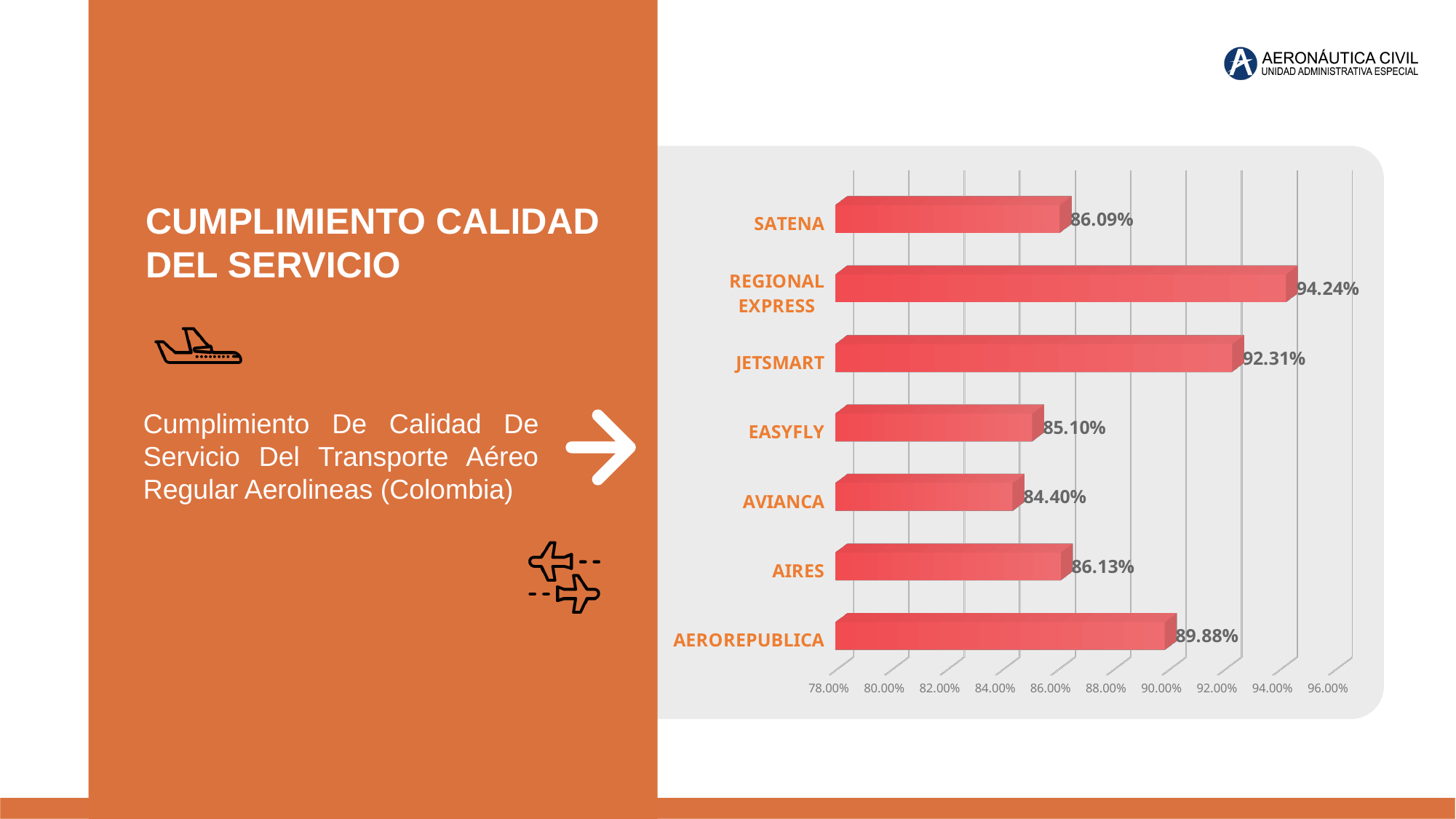
Which is larger, the value for SATENA or the value for EASYFLY? SATENA How many airlines are shown in the chart? 7 What is the lowest value shown on the x axis? 78.00% What is the value for JETSMART? 92.31% What kind of chart is shown on the slide? bar chart Which airline has the lowest value? AVIANCA What is the difference between the values for AIRES and SATENA? 0.04% What is the value for AEROREPUBLICA? 89.88% Which airline has the highest value? REGIONAL EXPRESS What is the difference between the values for REGIONAL EXPRESS and JETSMART? 1.93% Is the value for AEROREPUBLICA greater or less than 90.00%? less What is the value for AVIANCA? 84.40%